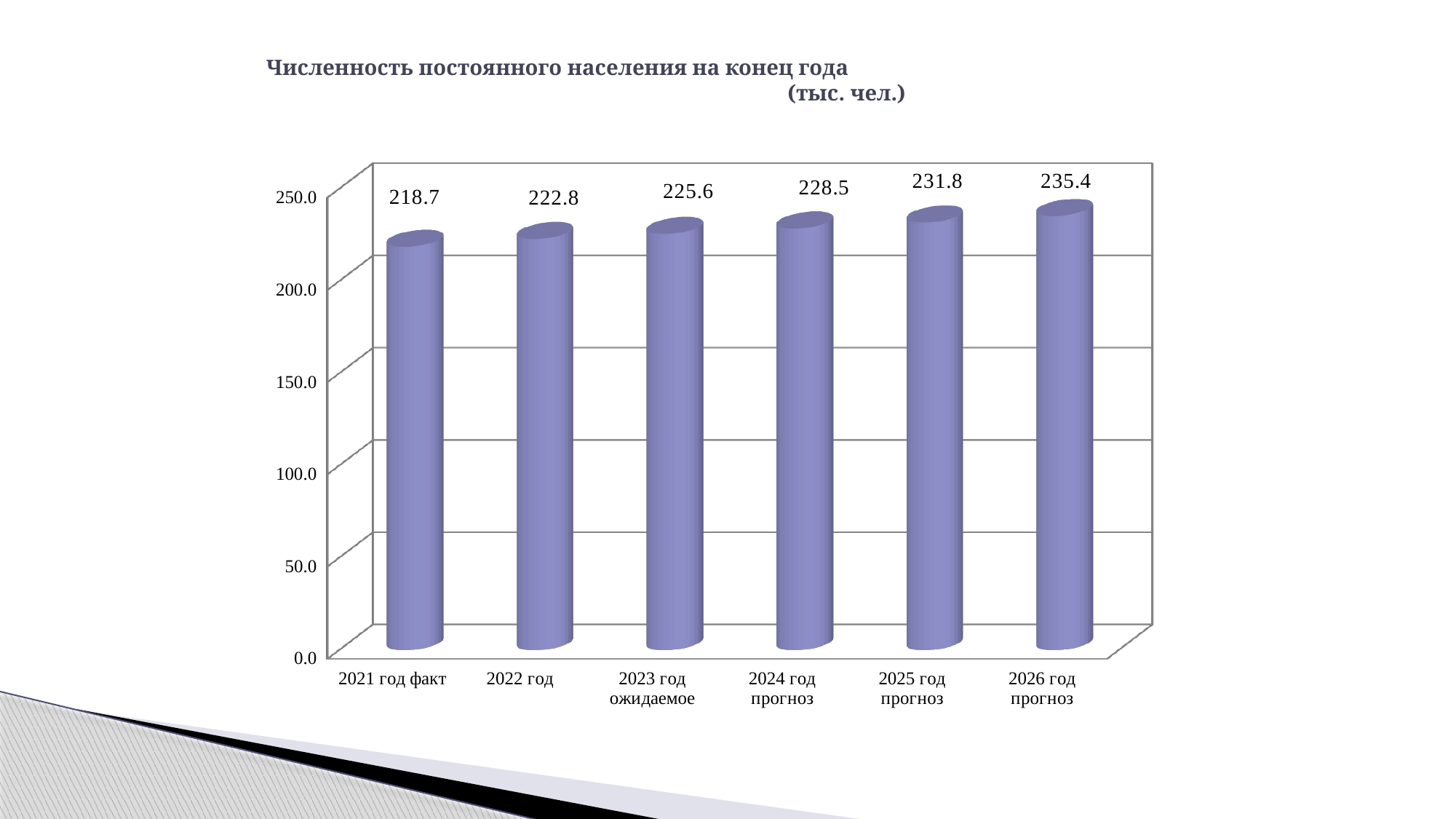
How many categories are shown on the x axis? 6 What is the difference between the values for 2026 год прогноз and 2021 год факт? 16.7 What is the value for 2024 год прогноз? 228.5 Which category has the highest value? 2026 год прогноз Is the value for 2023 год ожидаемое greater or less than 200.0? greater Which is larger, the value for 2025 год прогноз or the value for 2022 год? 2025 год прогноз What kind of chart is shown on the slide? bar chart Do the values rise or fall from 2021 год факт to 2026 год прогноз? rise Which category has the lowest value? 2021 год факт What is the value for 2021 год факт? 218.7 What is the difference between the values for 2023 год ожидаемое and 2022 год? 2.8 What is the value for 2026 год прогноз? 235.4